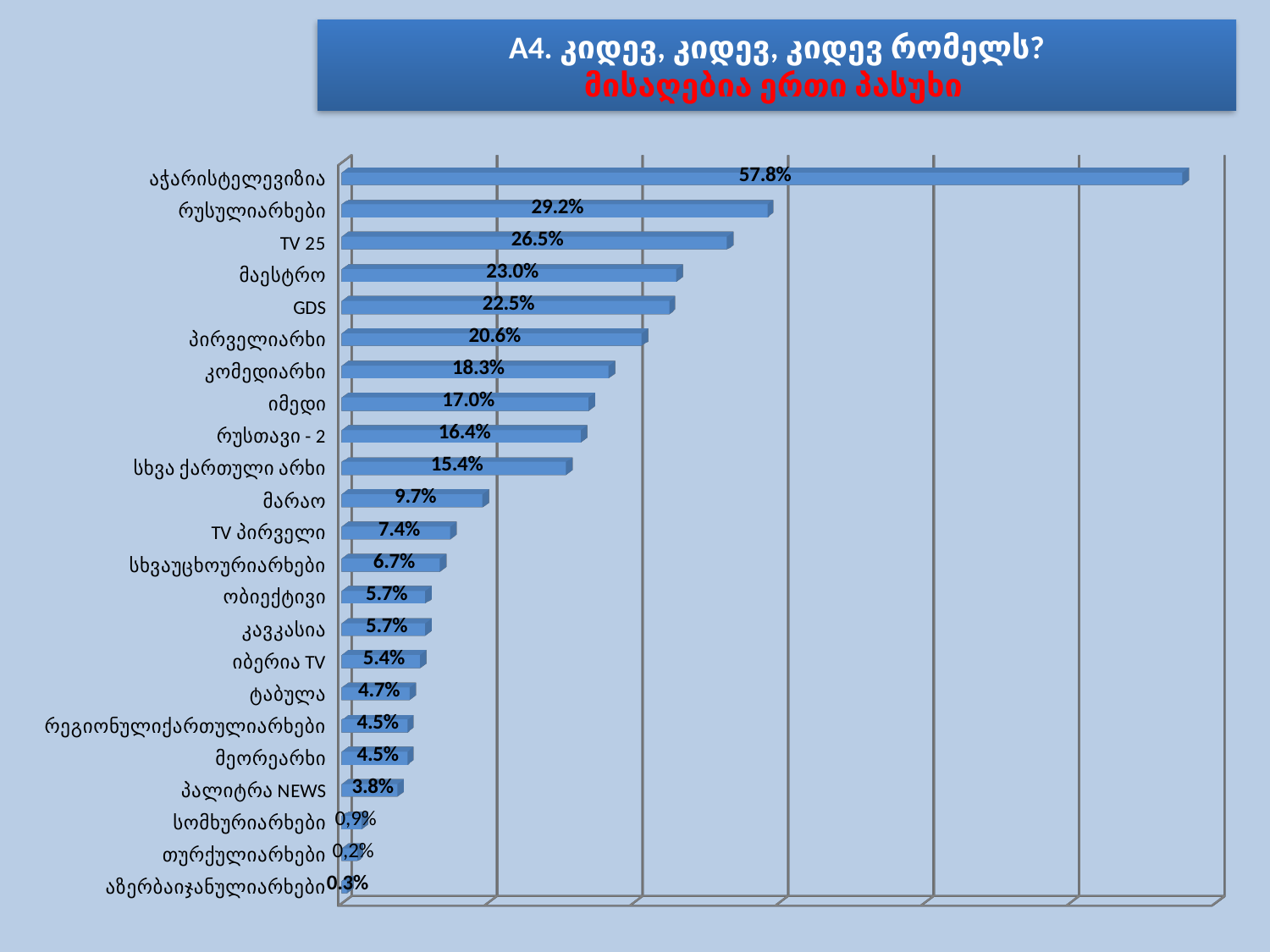
Which category has the lowest value? თურქულიარხები What is the value for TV 25? 26.5% What type of chart is shown on the slide? bar chart What is the value for GDS? 22.5% How many categories are shown in the chart? 23 What is the value for პალიტრა NEWS? 3.8% What is the difference between the values for აჭარისტელევიზია and რუსულიარხები? 28.6% What is the difference between the values for TV პირველი and მარაო? 2.3% Which is larger, the value for მაესტრო or the value for GDS? მაესტრო Which category has the highest value? აჭარისტელევიზია What is the value for იბერია TV? 5.4% What is the value for რუსთავი - 2? 16.4%